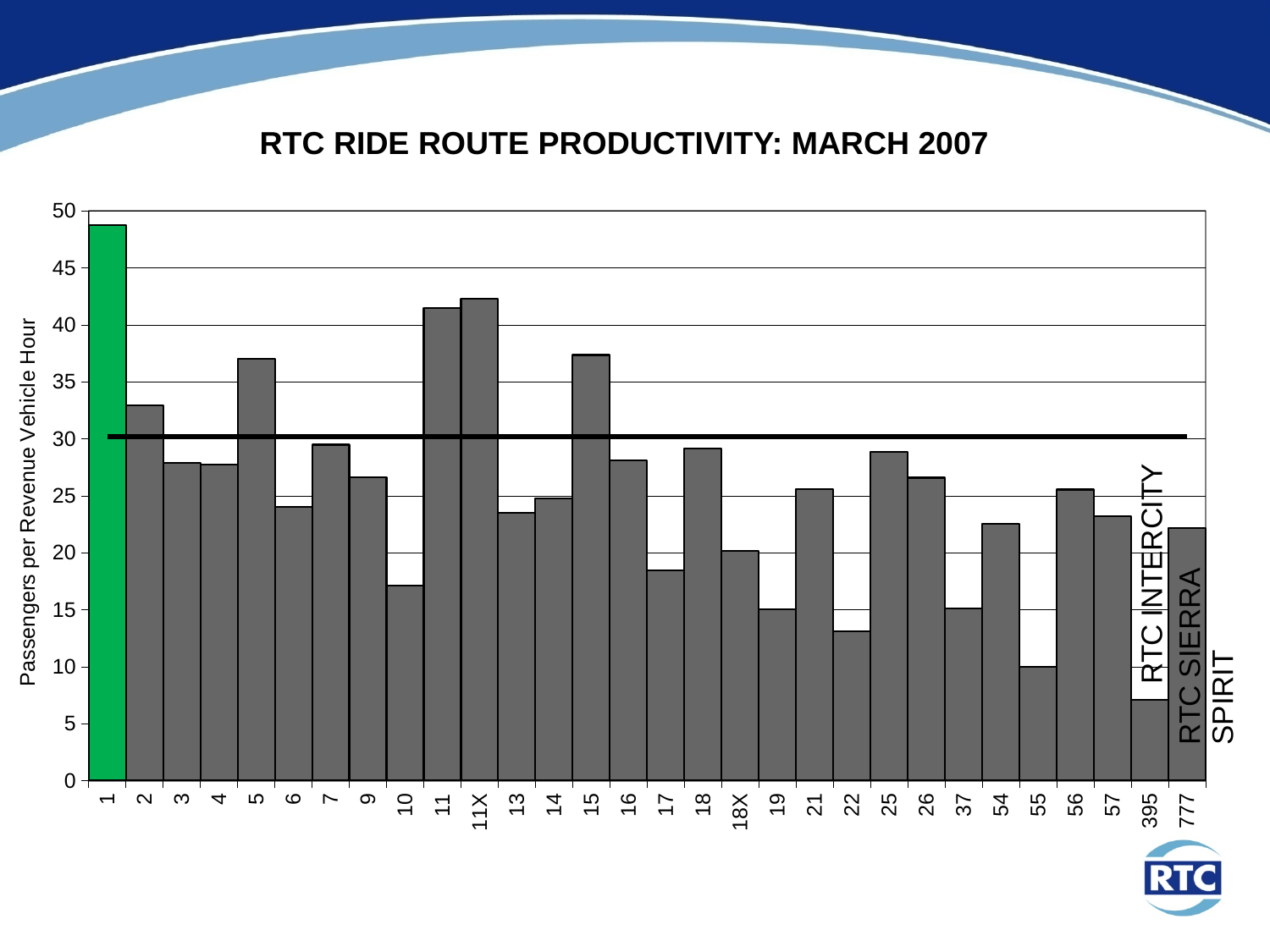
How many routes are shown on the x axis of the chart? 30 What kind of chart is shown on the slide? bar chart Is the value for route 10 greater or less than 20? less What is the title of the chart? RTC RIDE ROUTE PRODUCTIVITY: MARCH 2007 Which route has the highest passengers per revenue vehicle hour? 1 Is the value for route 22 greater or less than 15? less Which route has the lowest passengers per revenue vehicle hour? 395 Is the value for route 1 greater or less than 45? greater Which route has the larger value, route 9 or route 10? 9 What is the label on the vertical axis of the chart? Passengers per Revenue Vehicle Hour Which route has the larger value, route 5 or route 6? 5